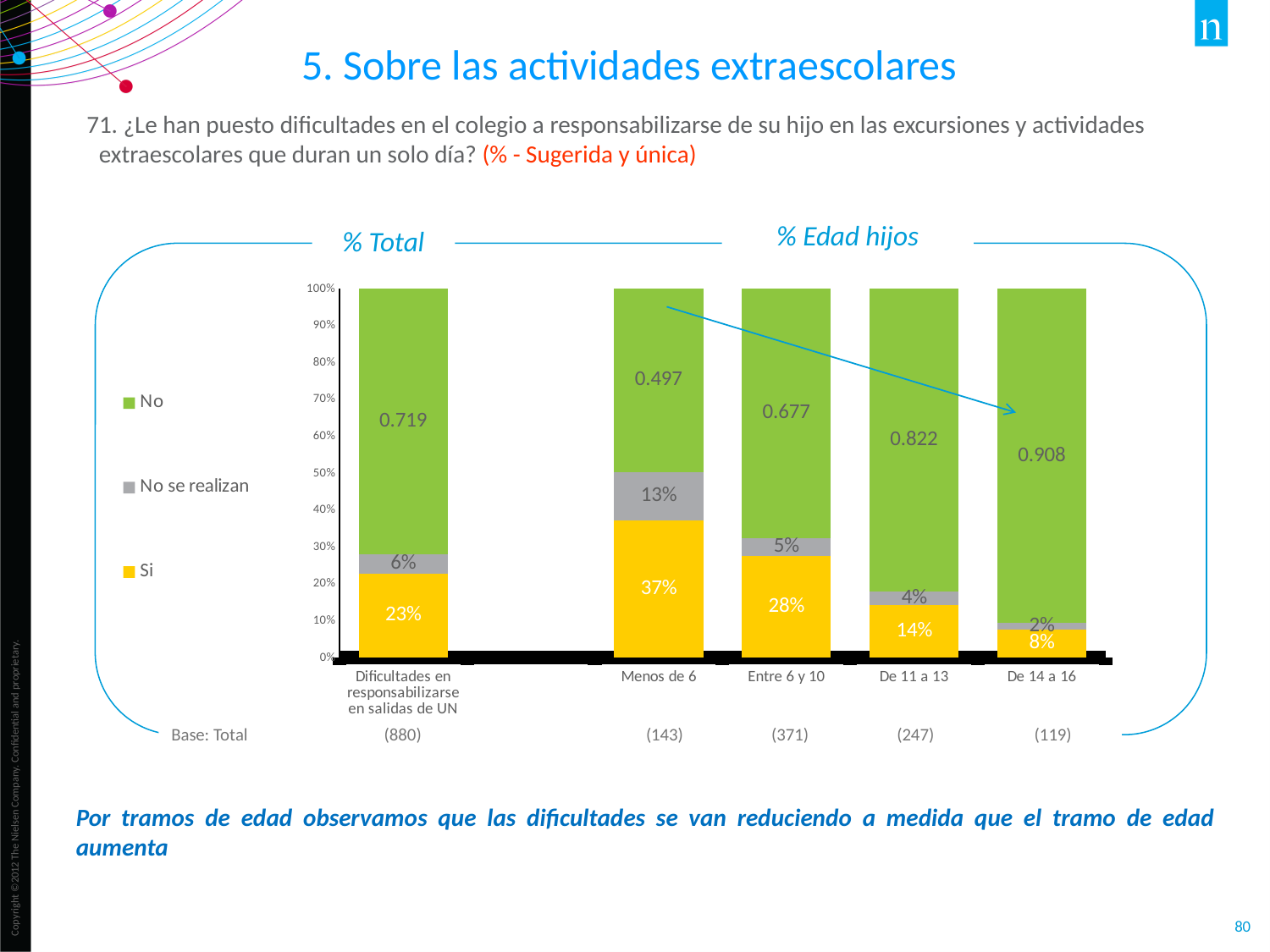
Which age category has the highest 'Si' value? Menos de 6 What is the value of the 'No se realizan' segment for 'Entre 6 y 10'? 5% What is the value of the 'Si' segment for the total bar 'Dificultades en responsabilizarse en salidas de UN'? 23% Which is larger, the 'No' value for 'Entre 6 y 10' or for 'De 11 a 13'? De 11 a 13 How many series does the legend list? 3 What type of chart is shown on the slide? stacked bar chart Which category has the lowest 'No se realizan' value? De 14 a 16 What is the difference between the 'Si' values for 'Menos de 6' and 'De 14 a 16'? 29% Does the 'Si' value rise or fall across the age categories from 'Menos de 6' to 'De 14 a 16'? fall What is the value of the 'No' segment for 'De 14 a 16'? 0.908 What is the value of the 'Si' segment for 'Menos de 6'? 37% How many categories are plotted along the x axis? 5